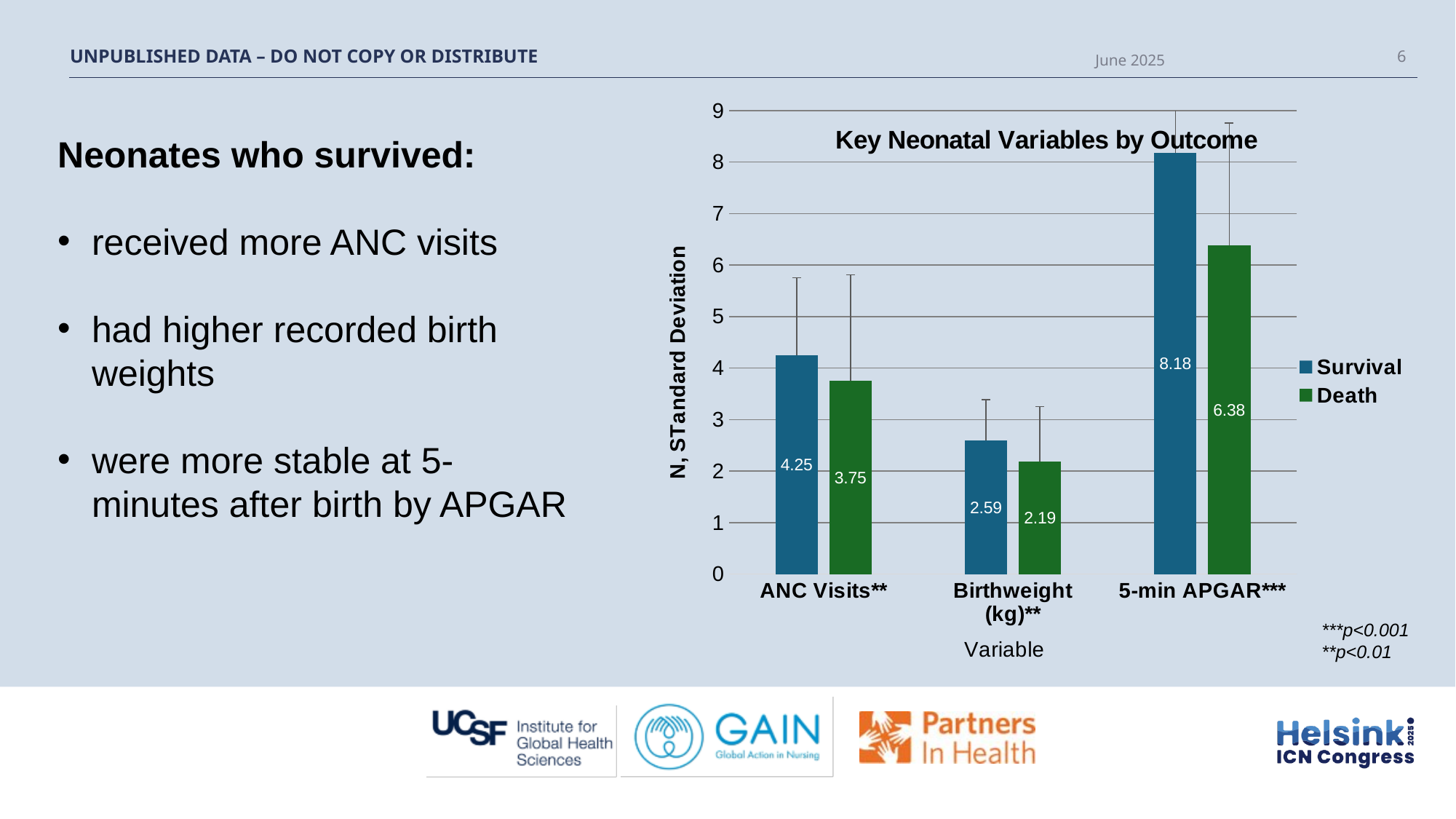
What is the Survival value for ANC Visits**? 4.25 What is the Death value for 5-min APGAR***? 6.38 How many series does the legend list? 2 What is the title of the chart? Key Neonatal Variables by Outcome Which category has the lowest Death value? Birthweight (kg)** What is the Survival value for 5-min APGAR***? 8.18 What is the difference between the Survival and Death values for ANC Visits**? 0.50 How many categories are shown on the x axis? 3 What is the difference between the Survival and Death values for 5-min APGAR***? 1.80 What is the Death value for Birthweight (kg)**? 2.19 For Birthweight (kg)**, which is larger: the Survival value or the Death value? Survival Which category has the highest Survival value? 5-min APGAR***